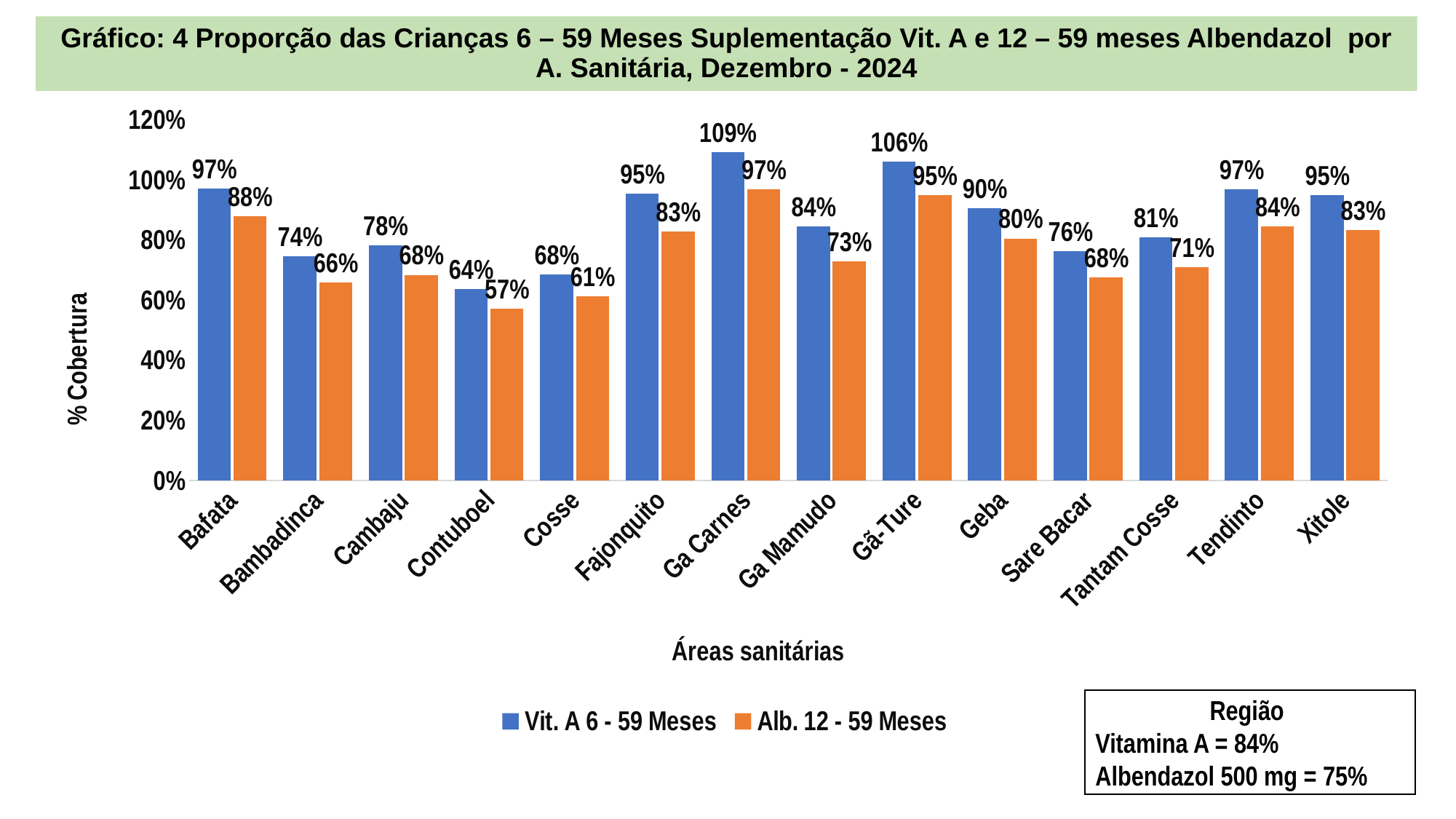
Is the Alb. 12 - 59 Meses value for Cosse greater or less than 80%? less What is the Vit. A 6 - 59 Meses value for Bafata? 97% How many series does the legend list? 2 What is the Alb. 12 - 59 Meses value for Ga Mamudo? 73% What is the Alb. 12 - 59 Meses value for Tendinto? 84% Which área sanitária has the highest Vit. A 6 - 59 Meses value? Ga Carnes What kind of chart is shown on the slide? bar chart How many áreas sanitárias are shown on the x axis? 14 What is the difference between the Vit. A 6 - 59 Meses and Alb. 12 - 59 Meses values for Gã-Ture? 11% Which área sanitária has the lowest Alb. 12 - 59 Meses value? Contuboel What is the label of the y axis? % Cobertura Which is larger: the Vit. A 6 - 59 Meses value for Geba or for Tantam Cosse? Geba